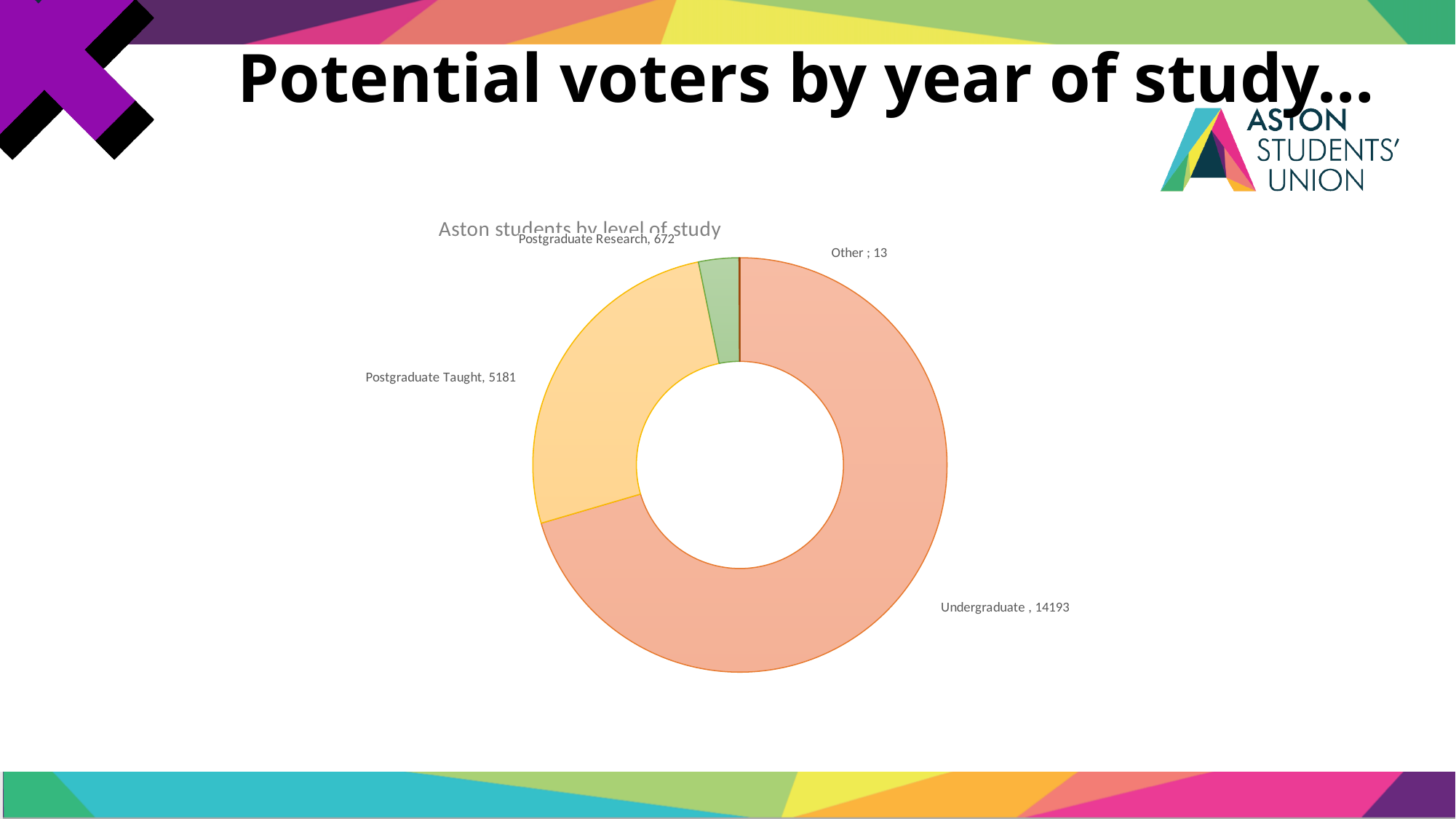
What is the value for Other in the chart? 13 What is the title of the chart? Aston students by level of study Which level of study has the largest number of students? Undergraduate What kind of chart is shown on the slide? Doughnut chart Which is larger, Postgraduate Research or Other? Postgraduate Research What is the value for Undergraduate in the chart? 14193 What is the value for Postgraduate Research in the chart? 672 What is the value for Postgraduate Taught in the chart? 5181 What is the difference between the Postgraduate Taught and Postgraduate Research values? 4509 How many categories are shown in the chart? 4 Which level of study has the smallest number of students? Other What is the difference between the Undergraduate and Postgraduate Taught values? 9012